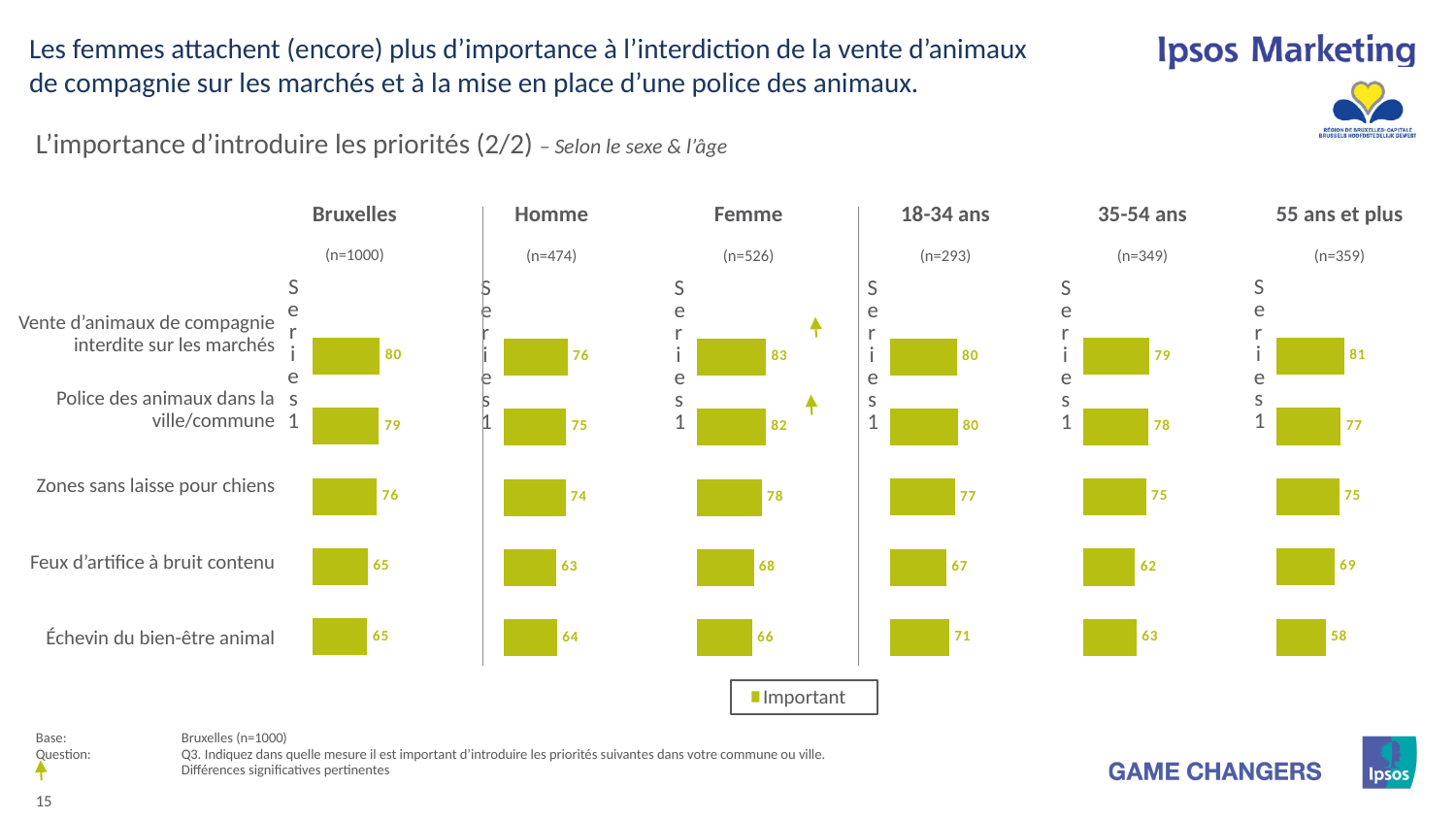
Which is larger: the 18-34 ans value or the 55 ans et plus value for "Échevin du bien-être animal"? 18-34 ans In the 55 ans et plus chart, what is the value for "Échevin du bien-être animal"? 58 What is the sample size (n) shown for the Femme chart? n=526 In the 18-34 ans chart, which category has the lowest value? Feux d'artifice à bruit contenu What is the difference between the Femme and Homme values for "Vente d'animaux de compagnie interdite sur les marchés"? 7 What type of chart is used on the slide? Bar chart In the Femme chart, what is the value for "Police des animaux dans la ville/commune"? 82 In the Femme chart, which category has the highest value? Vente d'animaux de compagnie interdite sur les marchés In the 35-54 ans chart, what is the difference between "Zones sans laisse pour chiens" and "Feux d'artifice à bruit contenu"? 13 How many categories are shown in each chart on the slide? 5 In the Bruxelles chart, what is the value for "Vente d'animaux de compagnie interdite sur les marchés"? 80 In the Homme chart, which category has the lowest value? Feux d'artifice à bruit contenu